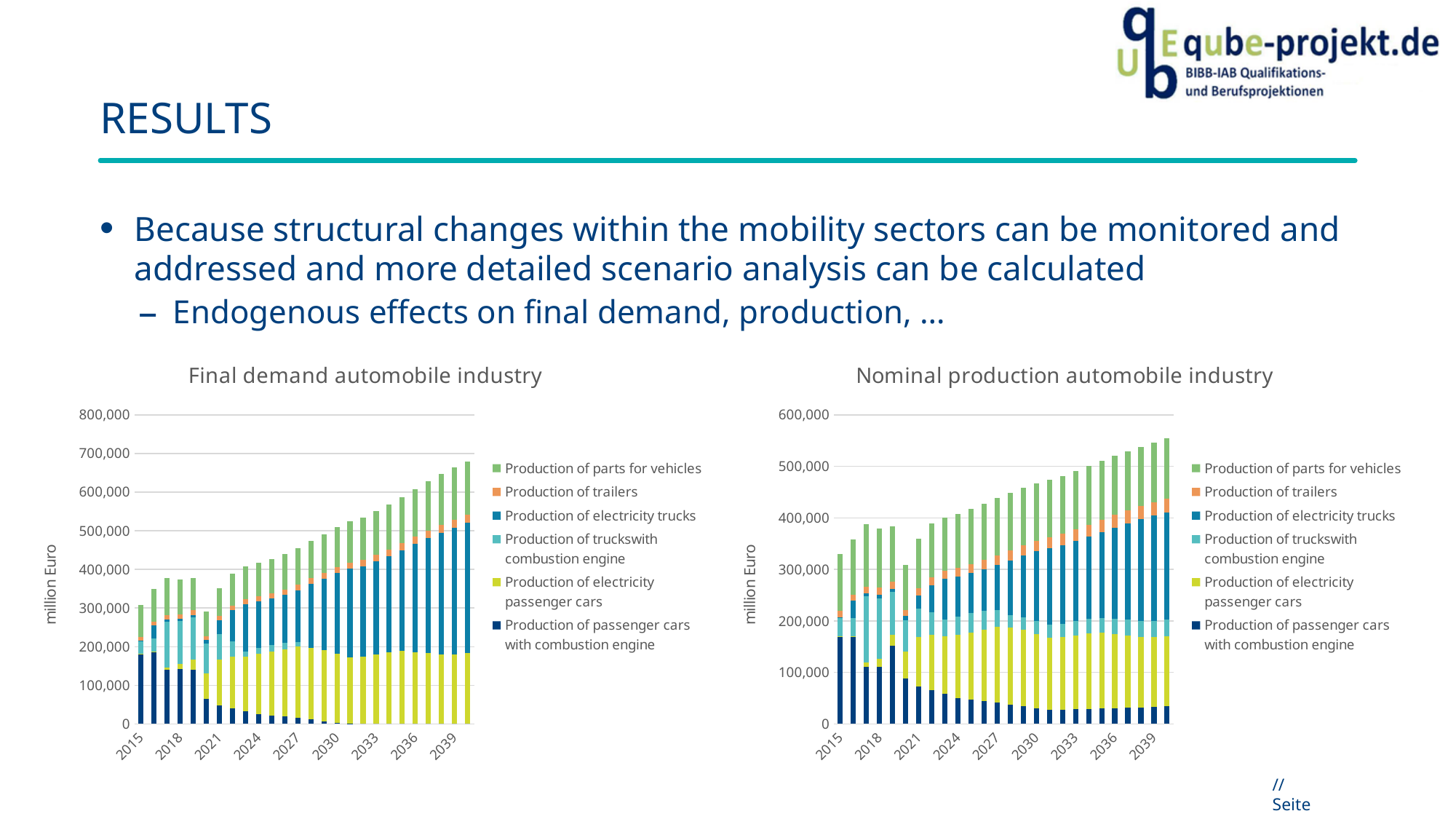
What is the y-axis label on the 'Final demand automobile industry' chart? million Euro In the 'Nominal production automobile industry' chart, which year has the larger total, 2018 or 2039? 2039 In the 'Final demand automobile industry' chart, is the total for 2039 greater or less than 600,000? greater In the 'Nominal production automobile industry' chart, is the total for 2039 greater or less than 500,000? greater What kind of chart is the 'Final demand automobile industry' chart? stacked bar chart What is the title of the chart on the right side of the slide? Nominal production automobile industry In the 'Nominal production automobile industry' chart, do the total bar heights generally rise or fall from 2021 to 2039? rise In the 'Final demand automobile industry' chart, is the total for 2015 greater or less than 400,000? less In the 'Final demand automobile industry' chart, do the total bar heights generally rise or fall from 2021 to 2039? rise How many series does the legend of the 'Nominal production automobile industry' chart list? 6 In the 'Final demand automobile industry' chart, which year has the larger total, 2015 or 2039? 2039